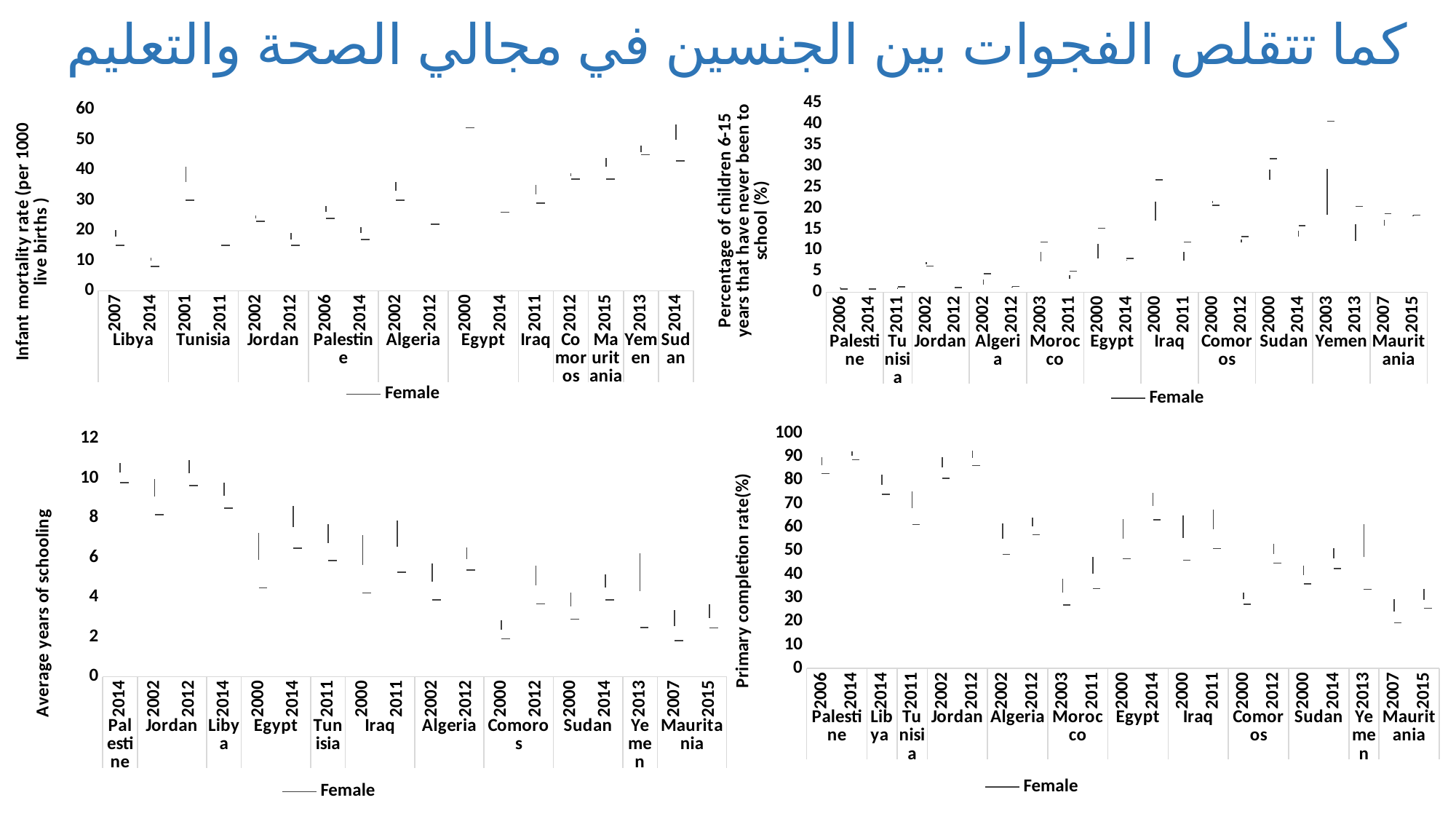
On the top-left chart (Infant mortality rate), is the value for Egypt 2000 greater or less than 40? greater What is the y-axis title of the top-left chart? Infant mortality rate (per 1000 live births ) On the bottom-right chart (Primary completion rate), how many countries are shown on the x axis? 12 On the top-left chart (Infant mortality rate), which is larger: the value for Libya 2007 or the value for Egypt 2000? Egypt 2000 On the bottom-right chart (Primary completion rate), is the value for Mauritania 2007 greater or less than 50? less On the top-right chart (Percentage of children 6-15 years that have never been to school), is the value for Palestine 2006 greater or less than 5? less How many series does the legend of the bottom-left chart (Average years of schooling) list? 1